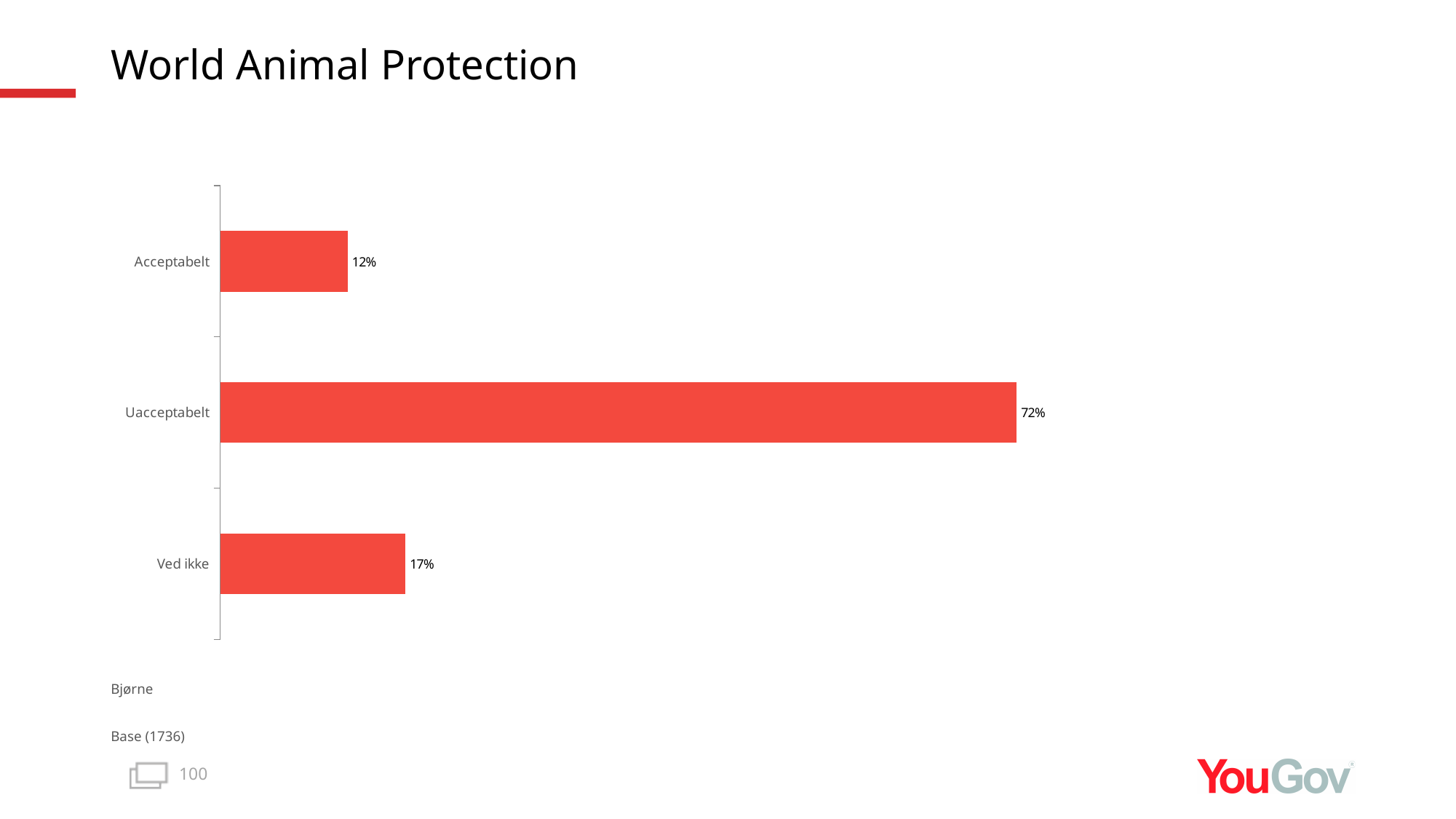
What is the difference between the values for Ved ikke and Acceptabelt? 5 percentage points Which category has the lowest value? Acceptabelt What is the value for Uacceptabelt? 72% Which is larger, the value for Ved ikke or the value for Acceptabelt? Ved ikke Which category has the highest value? Uacceptabelt How many categories are shown in the chart? 3 What is the value for Ved ikke? 17% What is the base (sample size) stated below the chart? 1736 What is the value for Acceptabelt? 12% What colour are the bars in the chart? Red What kind of chart is shown on the slide? Bar chart What is the difference between the values for Uacceptabelt and Acceptabelt? 60 percentage points